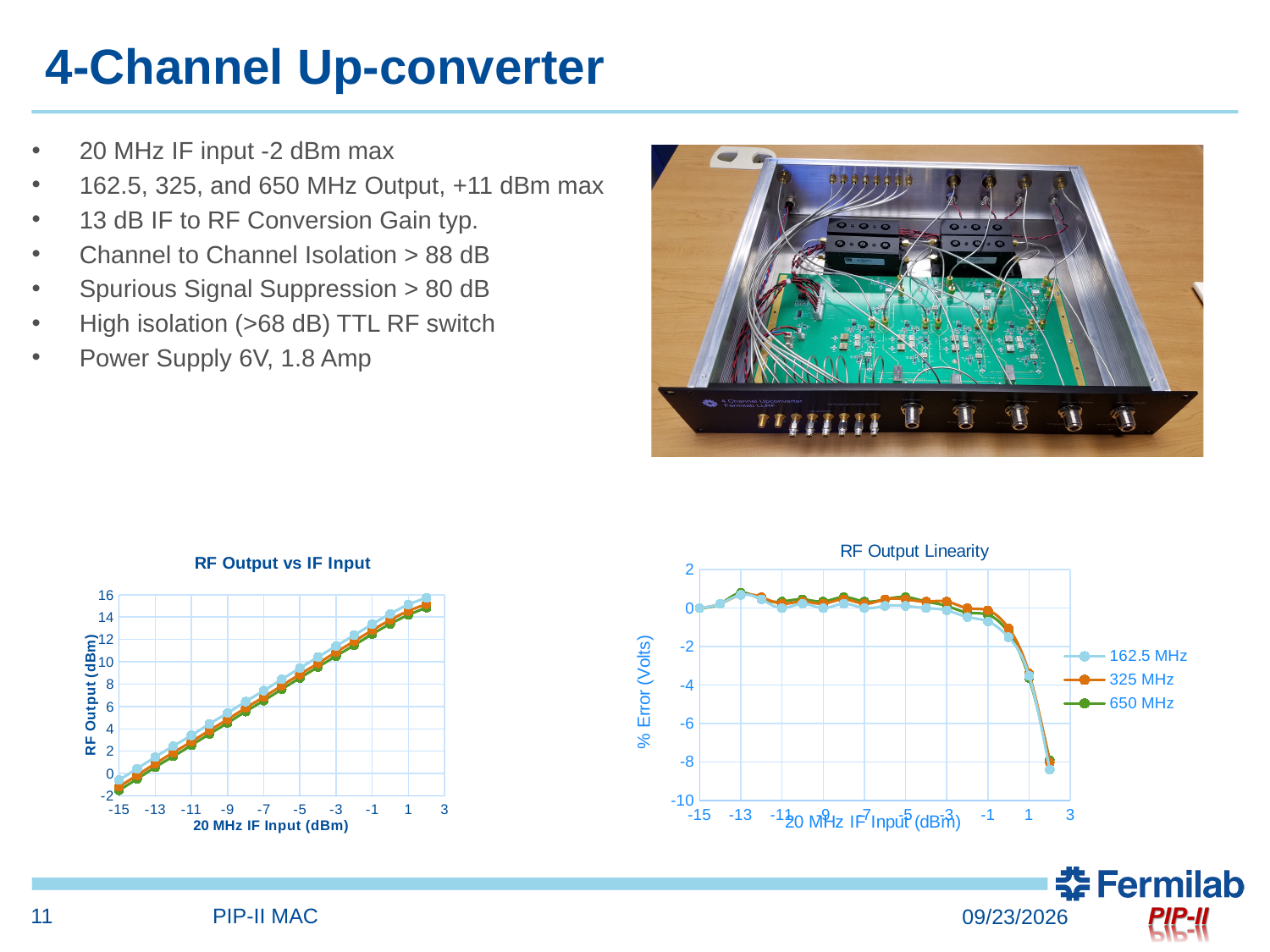
In the "RF Output vs IF Input" chart, is the RF Output at an IF input of -15 dBm greater or less than 2? less In the "RF Output Linearity" chart, do the plotted values rise or fall as the IF input goes from -1 dBm to 3 dBm? fall In the "RF Output Linearity" chart, what are the three series named in the legend? 162.5 MHz, 325 MHz, 650 MHz What kind of chart is the "RF Output vs IF Input" chart? line chart In the "RF Output Linearity" chart, how many series does the legend list? 3 In the "RF Output Linearity" chart, is the % Error at the highest IF input plotted (about 2 dBm) greater or less than -6? less In the "RF Output vs IF Input" chart, is the RF Output at an IF input of 1 dBm greater or less than 12? greater What kind of chart is the "RF Output Linearity" chart? line chart In the "RF Output vs IF Input" chart, do the plotted values rise or fall as the 20 MHz IF Input increases from -15 to 3 dBm? rise What is the y-axis label of the "RF Output vs IF Input" chart? RF Output (dBm)